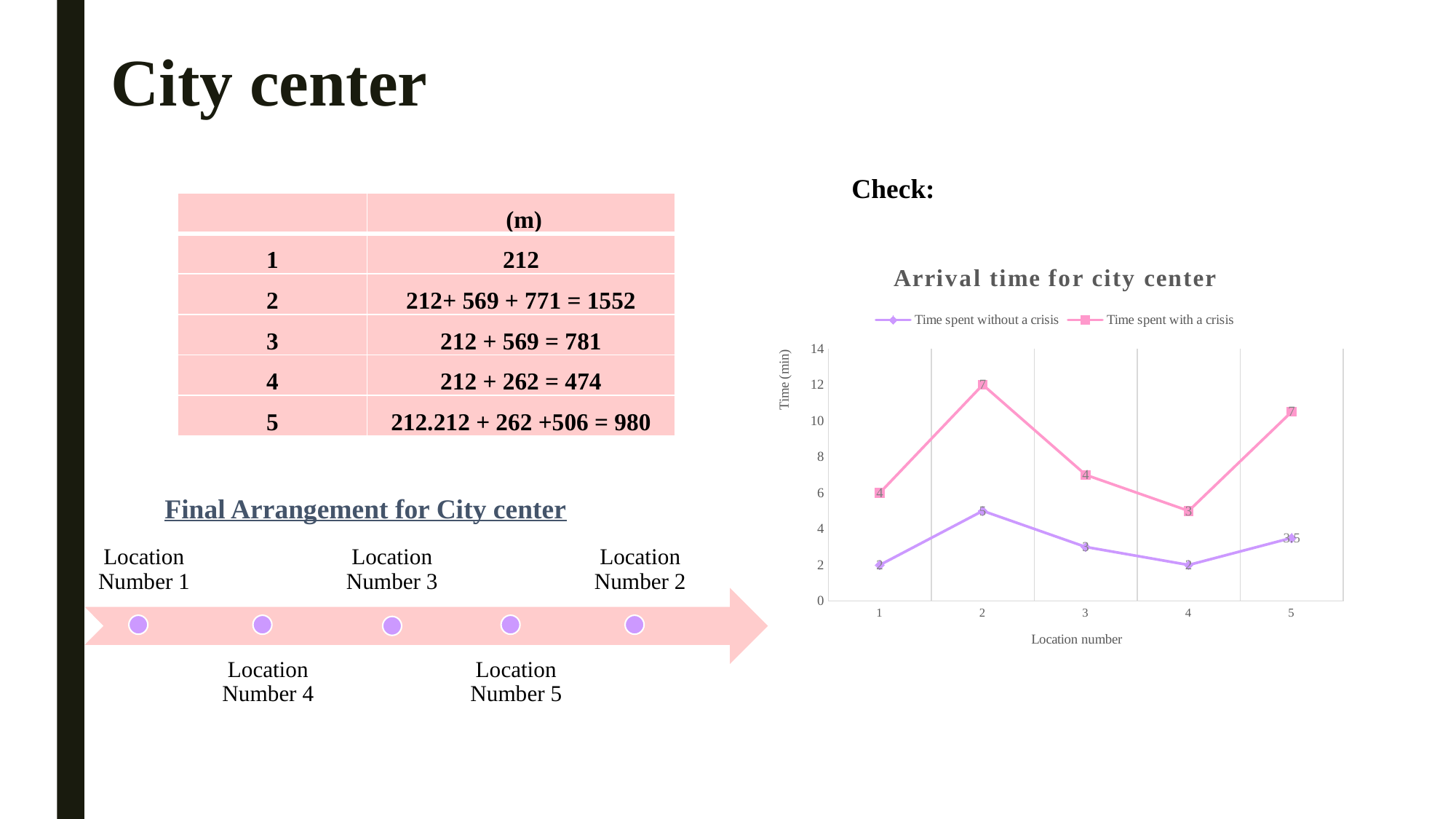
In the "Arrival time for city center" chart, what is the time spent without a crisis at location number 5? 3.5 What is the y-axis title of the "Arrival time for city center" chart? Time (min) What kind of chart is "Arrival time for city center"? line chart In the "Arrival time for city center" chart, what is the time spent without a crisis at location number 2? 5 How many location numbers are plotted along the x axis of the "Arrival time for city center" chart? 5 How many series does the legend of the "Arrival time for city center" chart list? 2 In the "Arrival time for city center" chart, what is the difference between the time spent with a crisis and without a crisis at location number 3? 1 In the "Arrival time for city center" chart, what is the time spent with a crisis at location number 3? 4 In the "Arrival time for city center" chart, is the time spent with a crisis larger at location number 1 or location number 4? location number 1 In the "Arrival time for city center" chart, at which location number is the time spent without a crisis highest? 2